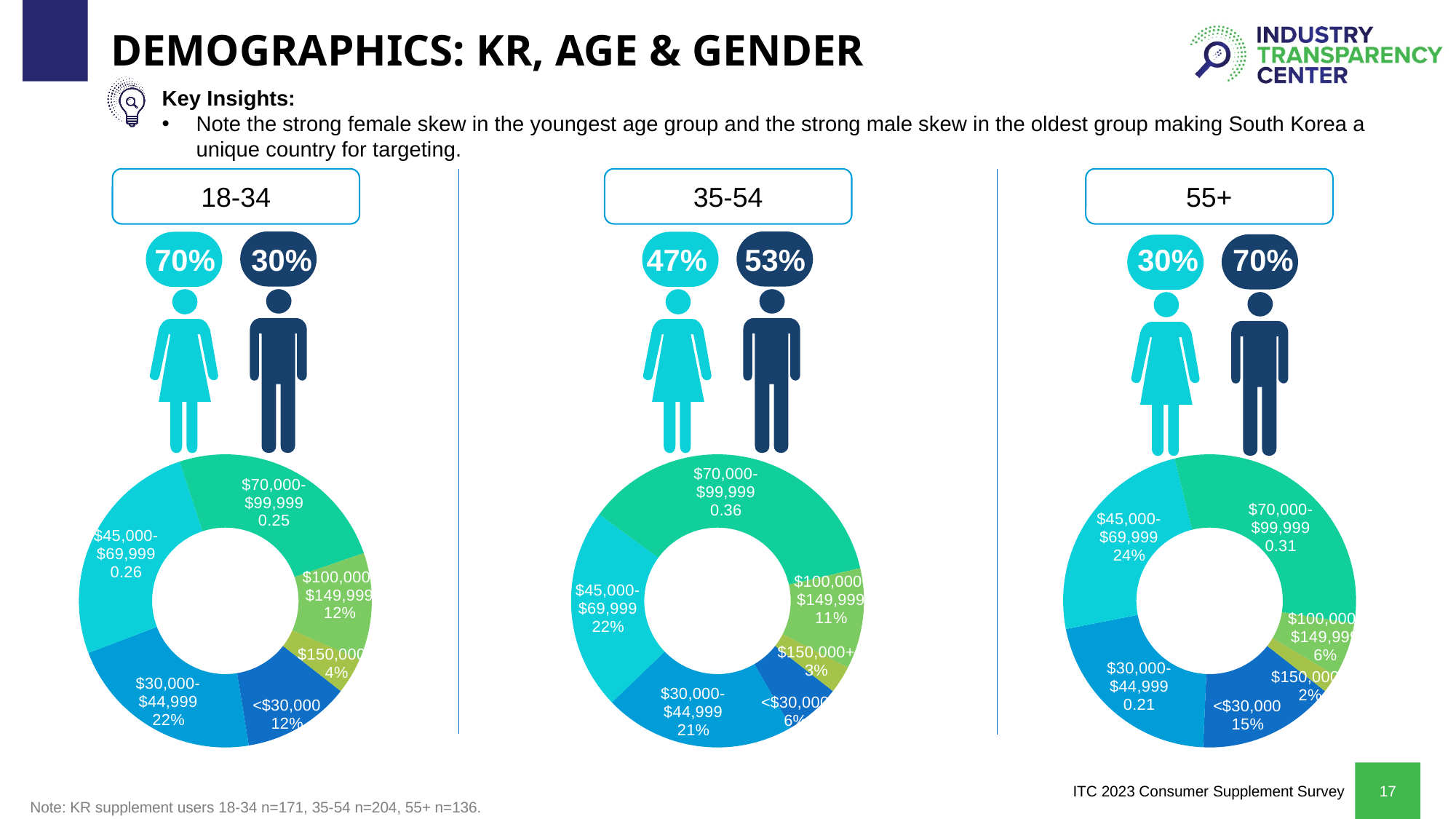
In the 18-34 chart, what share of respondents earn $70,000-$99,999? 0.25 In the 18-34 chart, what share of respondents earn less than $30,000? 12% In the 35-54 chart, what share of respondents earn $70,000-$99,999? 0.36 In the 35-54 chart, which income category has the largest share? $70,000-$99,999 In the 35-54 chart, what is the difference between the $45,000-$69,999 share and the $30,000-$44,999 share? 1 percentage point What kind of chart is used to show the income breakdown for each age group? Pie (donut) chart In the 55+ chart, what share of respondents earn $45,000-$69,999? 24% In the 18-34 chart, which income category has the smallest share? $150,000+ What percentage of the 55+ age group is male? 70% In the 55+ chart, which income category has the smallest share? $150,000+ In the 55+ chart, which is larger: the share earning less than $30,000 or the share earning $100,000-$149,999? <$30,000 How many income categories are shown in the 55+ chart? 6